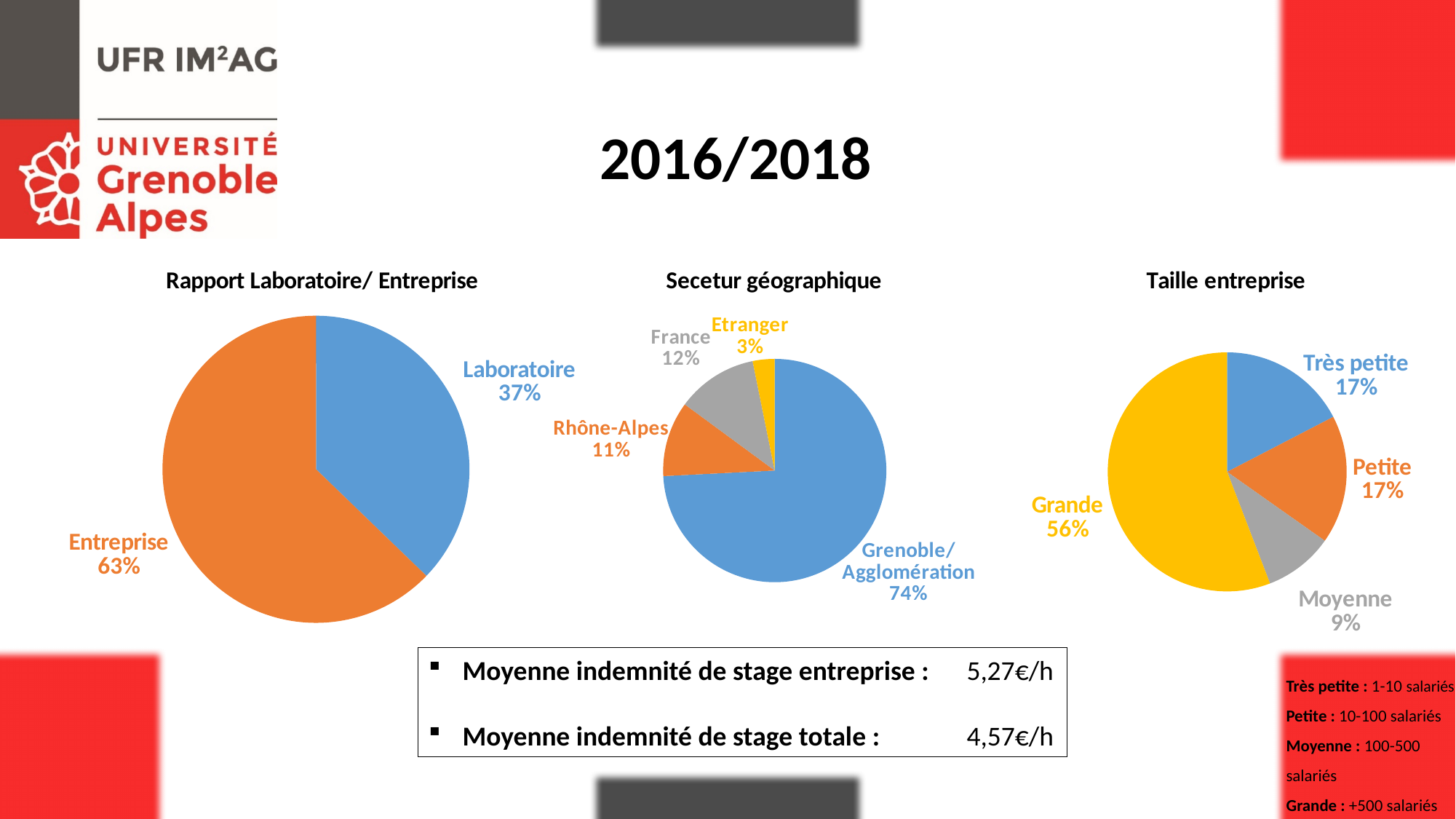
What kind of chart is the 'Rapport Laboratoire/ Entreprise' chart? pie chart How many pie charts are on the slide? 3 In the 'Secetur géographique' chart, what is the difference in percentage points between France and Rhône-Alpes? 1 In the 'Secetur géographique' chart, how many categories are shown? 4 In the 'Secetur géographique' chart, which category has the smallest share? Etranger In the 'Taille entreprise' chart, what share does Grande have? 56% In the 'Taille entreprise' chart, which category has the largest share? Grande In the 'Taille entreprise' chart, what share does Moyenne have? 9% In the 'Rapport Laboratoire/ Entreprise' chart, what share does Entreprise have? 63% In the 'Secetur géographique' chart, what share does Grenoble/Agglomération have? 74% In the 'Taille entreprise' chart, which is larger, Grande or Moyenne? Grande In the 'Rapport Laboratoire/ Entreprise' chart, what share does Laboratoire have? 37%